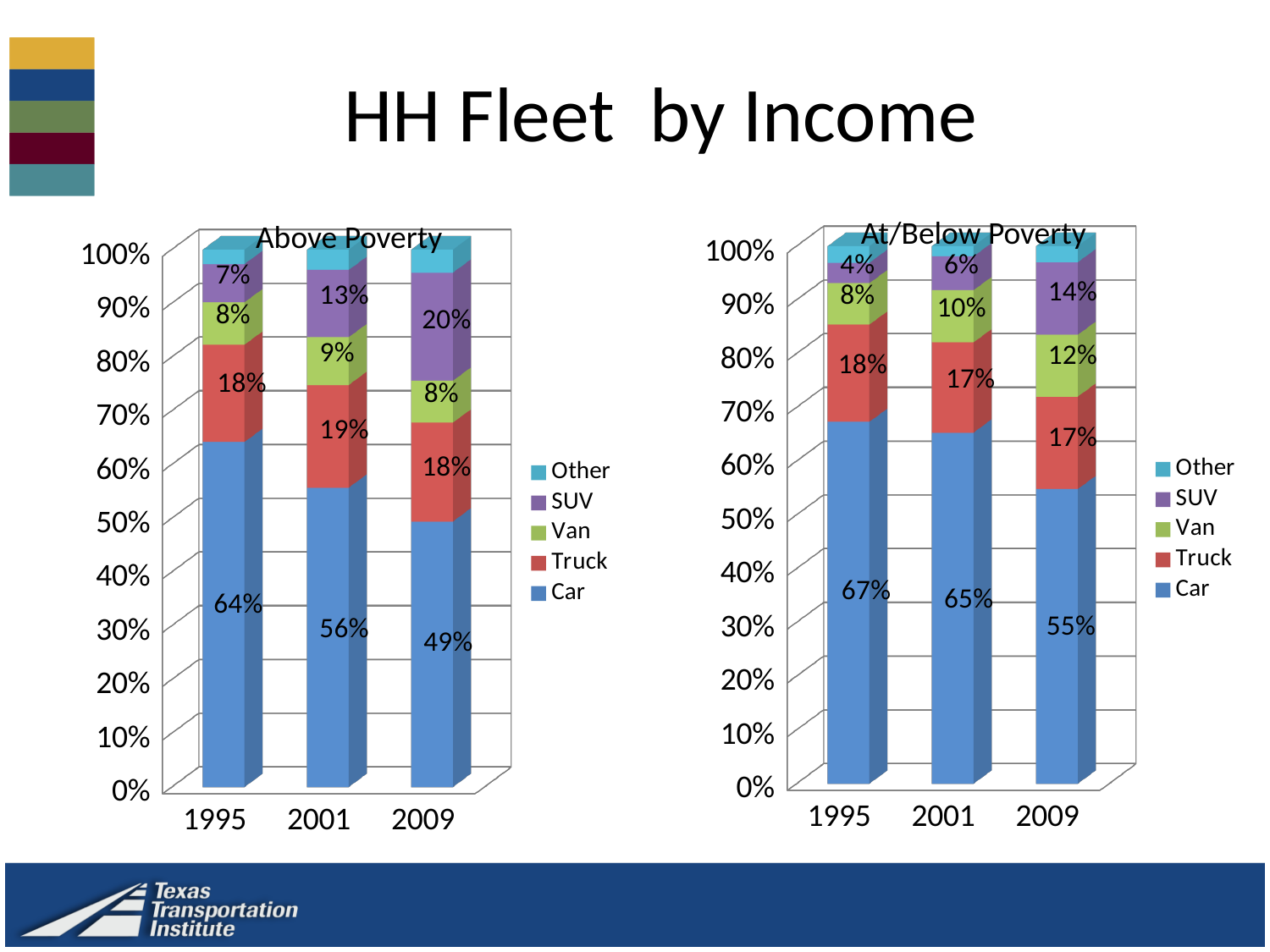
Which is larger: the 2009 SUV share in the Above Poverty chart or in the At/Below Poverty chart? Above Poverty What kind of chart is the At/Below Poverty chart? Stacked bar chart In the At/Below Poverty chart, which year has the highest SUV share? 2009 In the Above Poverty chart, what is the SUV share in 2009? 20% In the At/Below Poverty chart, what is the Car share in 2009? 55% In the Above Poverty chart, which year has the lowest Car share? 2009 In the Above Poverty chart, what is the Car share in 1995? 64% In the Above Poverty chart, by how many percentage points did the Car share fall from 1995 to 2009? 15 percentage points In the At/Below Poverty chart, what is the Van share in 2001? 10% How many series does the legend of the Above Poverty chart list? 5 How many years are shown on the x axis of the At/Below Poverty chart? 3 In the At/Below Poverty chart, what is the difference between the SUV share in 2009 and in 1995? 10 percentage points